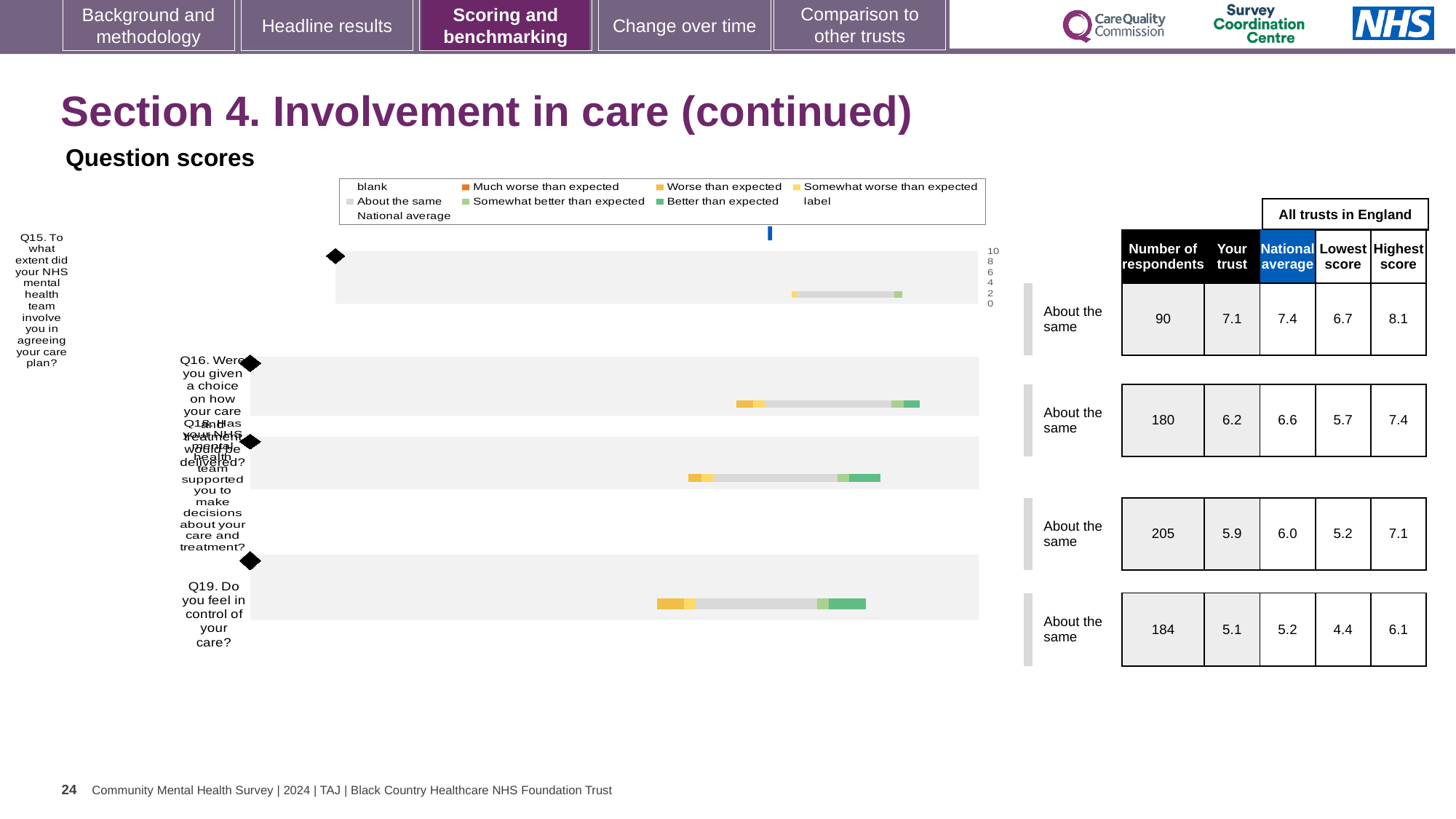
What is the national average score for Q16 (given a choice on how care and treatment would be delivered)? 6.6 Which question has the lowest 'Your trust' score? Q19 What is the lowest score among all trusts in England for Q19 (feeling in control of your care)? 4.4 What is the highest score among all trusts in England for Q15? 8.1 What is the difference between the national average and the 'Your trust' score for Q15? 0.3 How many respondents answered Q18 (supported to make decisions about care and treatment)? 205 What is the 'Your trust' score for Q15 (involvement in agreeing your care plan)? 7.1 How many survey questions (bars) are shown in the question scores chart? 4 For Q16, which is larger: the 'Your trust' score or the national average? National average What benchmark category is shown for Q19 in the question scores chart? About the same Which question has the highest 'Your trust' score? Q15 What kind of chart is used to show the question scores on this slide? bar chart